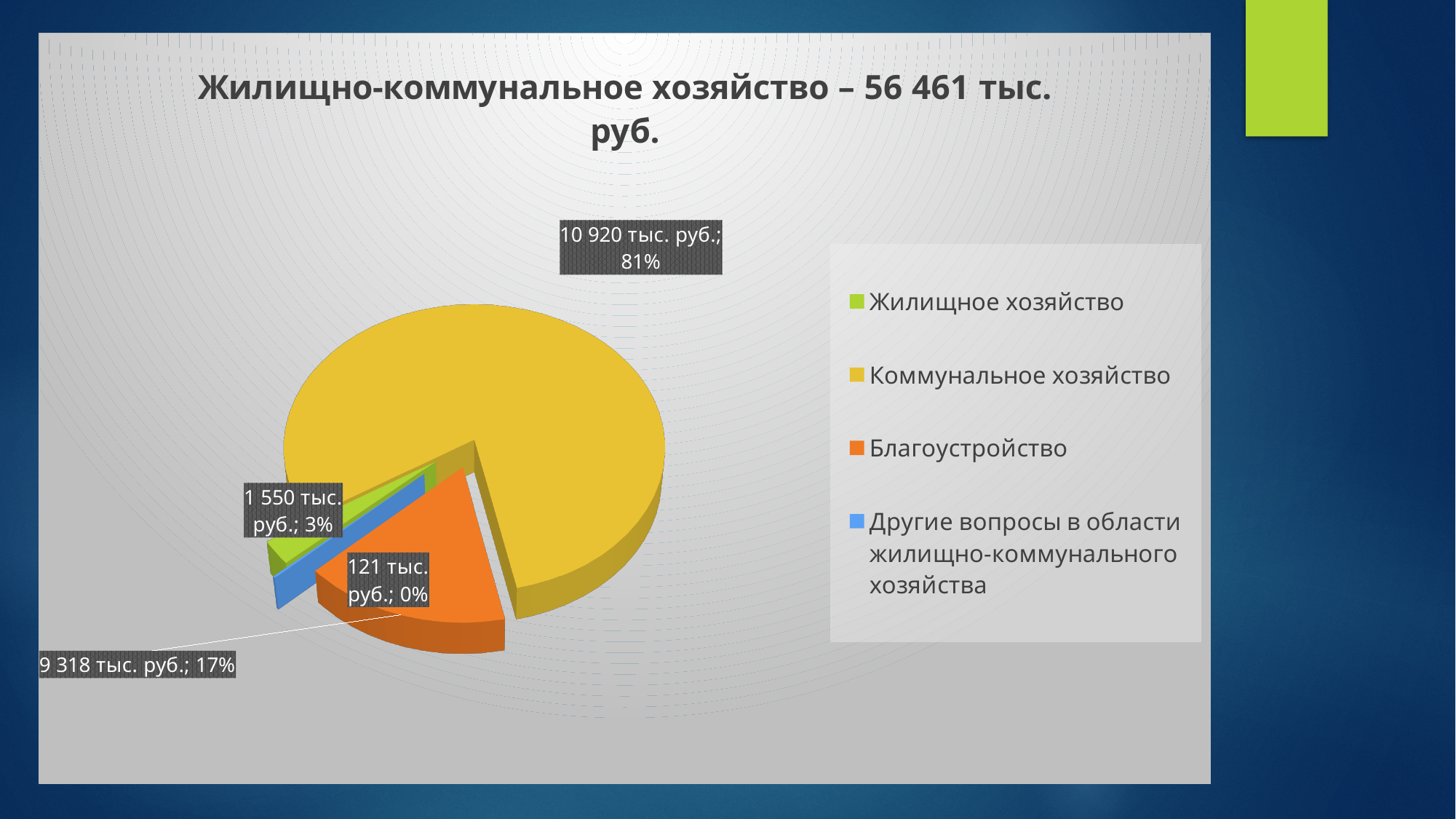
What share of the pie does Коммунальное хозяйство have? 81% Which category has the smallest slice of the pie? Другие вопросы в области жилищно-коммунального хозяйства What is the title of the chart? Жилищно-коммунальное хозяйство – 56 461 тыс. руб. Which is larger, the slice for Коммунальное хозяйство or the slice for Благоустройство? Коммунальное хозяйство Which category has the largest slice of the pie? Коммунальное хозяйство How many categories does the legend list? 4 What type of chart is shown on the slide? Pie chart What value is shown for Коммунальное хозяйство? 10 920 тыс. руб. What share of the pie does Жилищное хозяйство have? 3% What value is shown in the data label that reads 17%? 9 318 тыс. руб. What value is shown for Жилищное хозяйство? 1 550 тыс. руб. What is the difference between the values for Коммунальное хозяйство and Жилищное хозяйство? 9 370 тыс. руб.